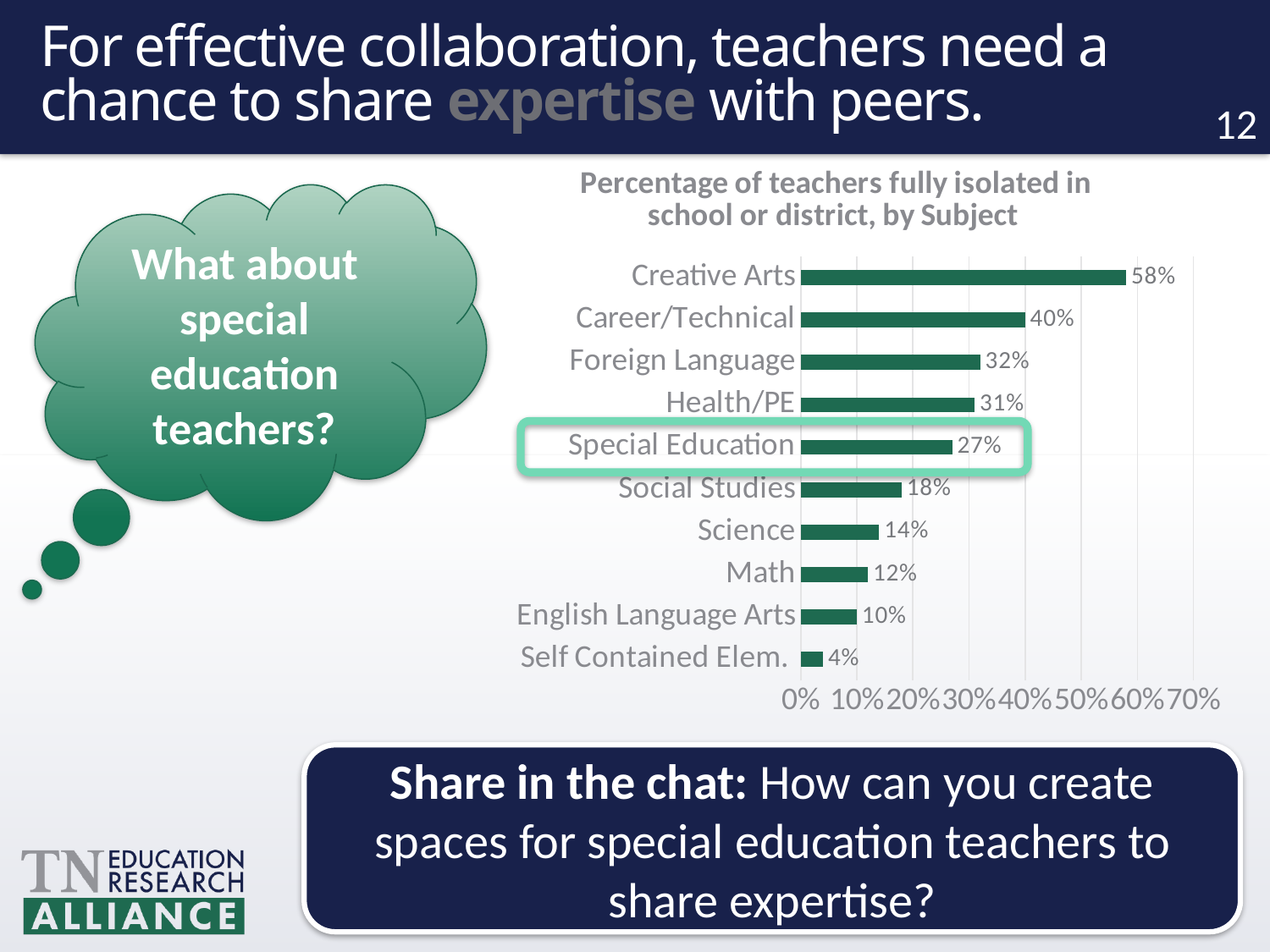
What is the value shown for Creative Arts? 58% What is the difference between the values for Special Education and Social Studies? 9% What is the difference between the values for Creative Arts and Career/Technical? 18% Which subject has the highest percentage of fully isolated teachers? Creative Arts Which subject has the lowest percentage of fully isolated teachers? Self Contained Elem. Which has a higher value, Foreign Language or Science? Foreign Language Which subject's bar is highlighted with a box on the chart? Special Education What is the title of the chart? Percentage of teachers fully isolated in school or district, by Subject What percentage of Special Education teachers are fully isolated in school or district? 27% How many subjects are shown in the chart? 10 What kind of chart is used to show the percentage of teachers fully isolated by subject? Bar chart What is the value shown for Math? 12%